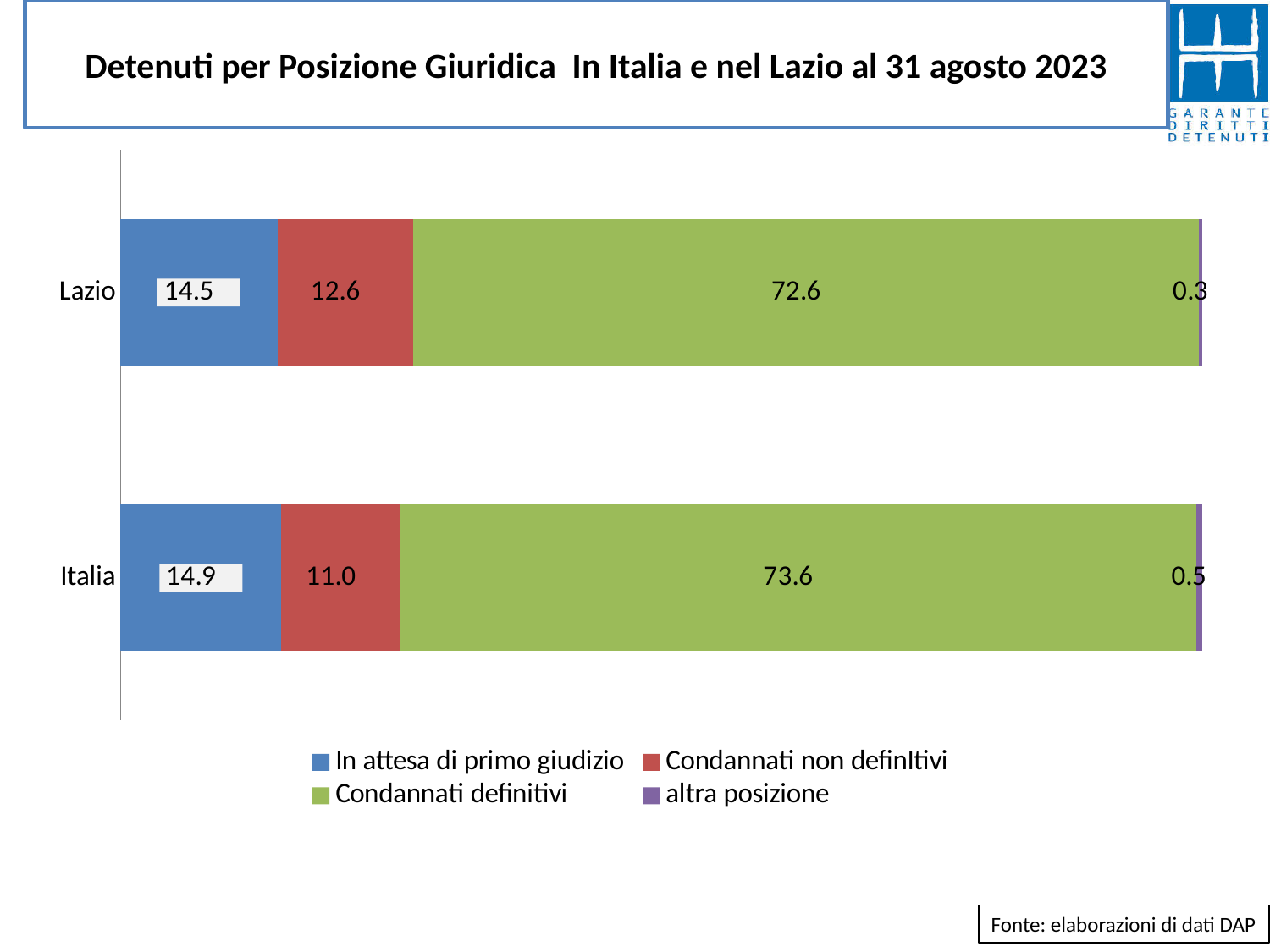
What kind of chart is shown on the slide? Stacked bar chart What is the value for "Condannati definitivi" for Lazio? 72.6 What is the value for "Condannati non definItivi" for Lazio? 12.6 What is the value for "altra posizione" for Italia? 0.5 What is the difference between the "Condannati non definItivi" values for Lazio and Italia? 1.6 How many categories are shown on the chart? 2 Which is larger, the "Condannati definitivi" value for Lazio or for Italia? Italia Which series has the largest value in the Italia bar? Condannati definitivi How many series does the legend list? 4 What is the value for "In attesa di primo giudizio" for Italia? 14.9 Which series has the smallest value in the Lazio bar? altra posizione What is the total of the stacked bar for Lazio? 100.0